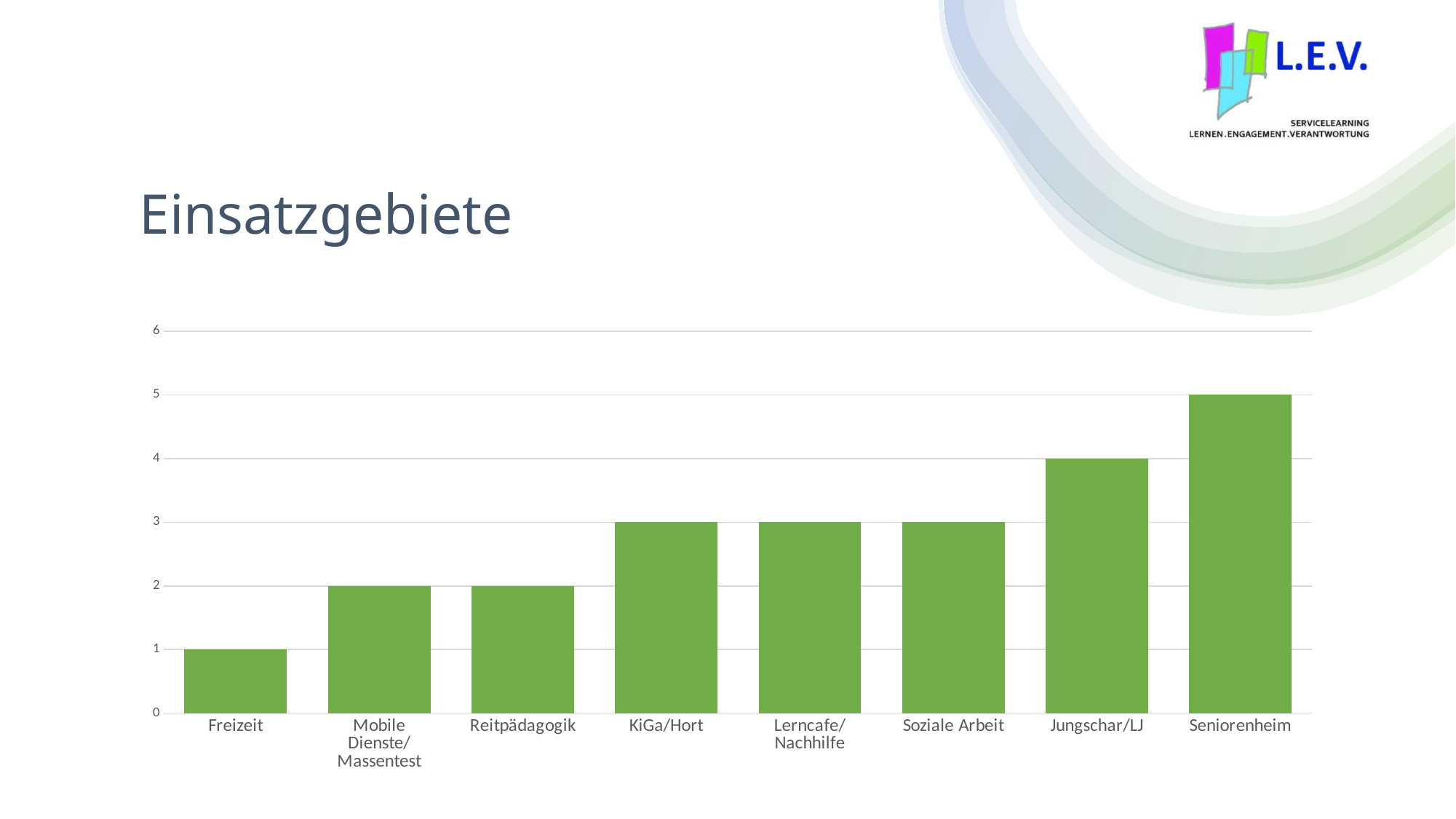
What is the value for Seniorenheim? 5 What is the value for Freizeit? 1 Which is larger, the value for KiGa/Hort or the value for Mobile Dienste/Massentest? KiGa/Hort What is the value for Reitpädagogik? 2 Do the values generally rise or fall from left to right along the x axis? Rise What is the value for Jungschar/LJ? 4 What is the title of the slide containing the chart? Einsatzgebiete What is the difference between the values for Seniorenheim and Freizeit? 4 What kind of chart is shown on the slide? Bar chart How many categories are shown on the x axis? 8 Which category has the highest value? Seniorenheim Which category has the lowest value? Freizeit